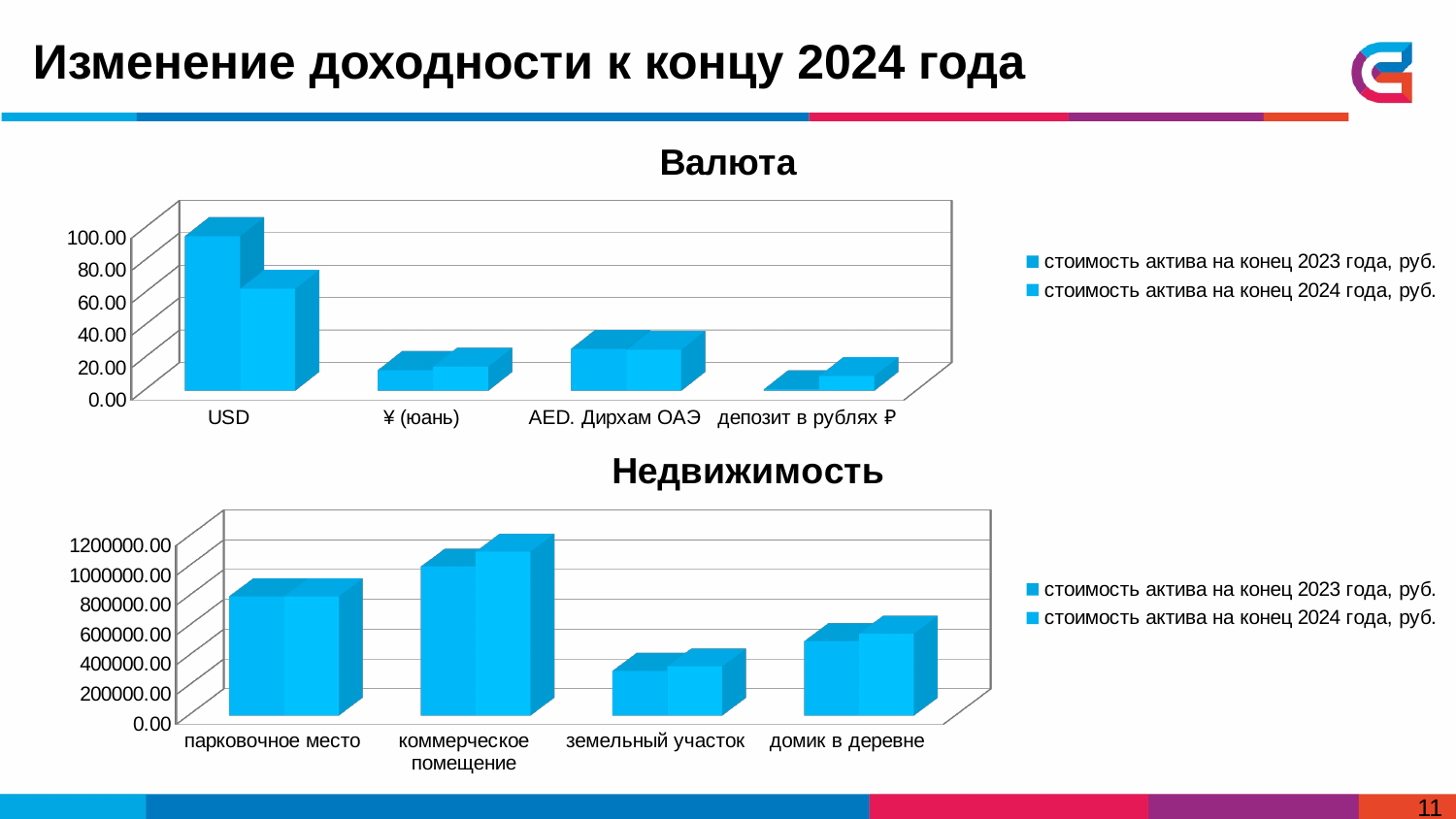
How many series does the legend of the "Валюта" chart list? 2 What is the title of the lower chart on the slide? Недвижимость In the "Валюта" chart, which category has the lowest value for "стоимость актива на конец 2023 года, руб."? депозит в рублях ₽ In the "Недвижимость" chart, is the value for "земельный участок" for "стоимость актива на конец 2023 года, руб." greater or less than 600000.00? less In the "Недвижимость" chart, for "стоимость актива на конец 2024 года, руб.", which is larger: "коммерческое помещение" or "домик в деревне"? коммерческое помещение In the "Валюта" chart, is the value for USD for "стоимость актива на конец 2023 года, руб." greater or less than 80.00? greater How many categories are shown on the x axis of the "Недвижимость" chart? 4 What kind of chart is the "Валюта" chart? bar chart In the "Недвижимость" chart, which category has the lowest value for "стоимость актива на конец 2023 года, руб."? земельный участок In the "Валюта" chart, which category has the highest value for "стоимость актива на конец 2023 года, руб."? USD In the "Недвижимость" chart, which category has the highest value for "стоимость актива на конец 2024 года, руб."? коммерческое помещение In the "Валюта" chart, for USD, which is larger: the value for "стоимость актива на конец 2023 года, руб." or for "стоимость актива на конец 2024 года, руб."? стоимость актива на конец 2023 года, руб.